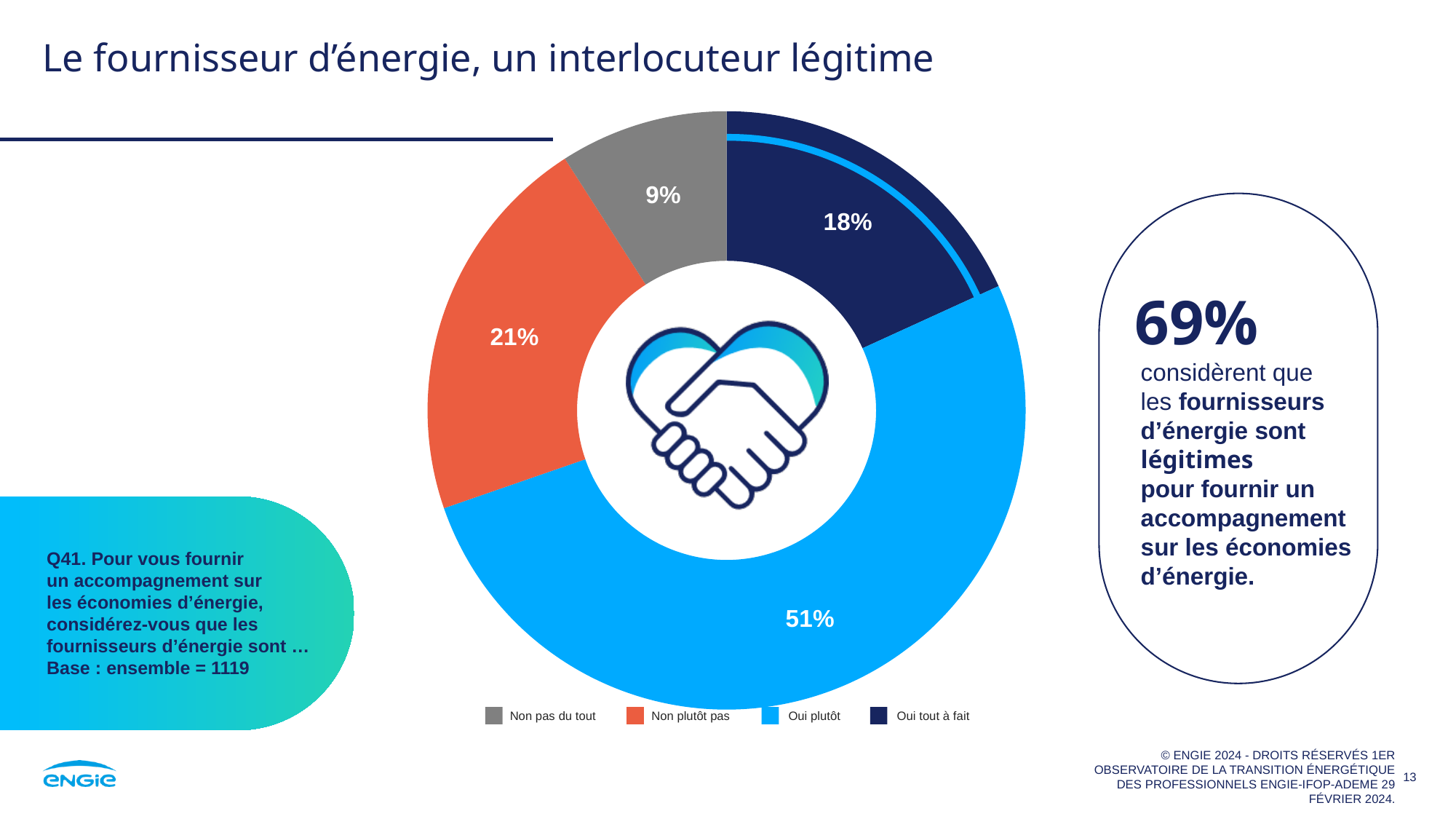
What percentage of respondents answered "Oui tout à fait"? 18% Which is larger, the share for "Oui tout à fait" or the share for "Non plutôt pas"? Non plutôt pas What percentage of respondents answered "Non pas du tout"? 9% Which response category has the smallest share of the chart? Non pas du tout What percentage of respondents answered "Oui plutôt"? 51% What type of chart is shown on the slide? Pie chart (donut) How many response categories are shown in the chart? 4 What is the difference between the "Oui plutôt" share and the "Non plutôt pas" share? 30 percentage points Which colour represents "Non pas du tout" in the legend? Grey Which response category has the largest share of the chart? Oui plutôt What is the combined share of "Oui plutôt" and "Oui tout à fait"? 69% What percentage of respondents answered "Non plutôt pas"? 21%